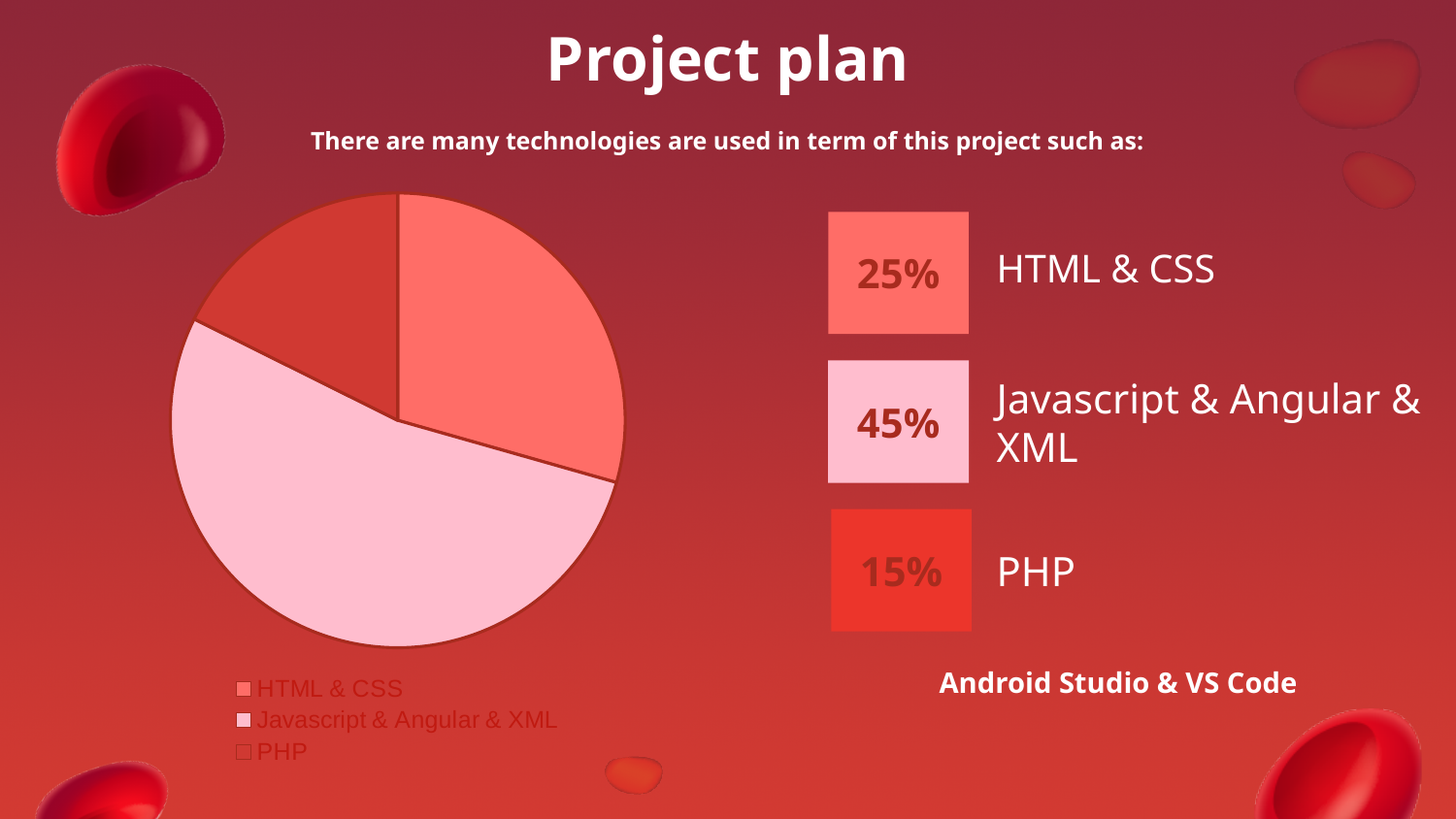
How many slices does the pie chart have? 3 What kind of chart is shown on the slide? pie chart Which technology has the largest slice of the pie chart? Javascript & Angular & XML What percentage is shown for PHP? 15% Which technology has the smallest slice of the pie chart? PHP Which legend entry is shown in light pink? Javascript & Angular & XML What percentage is shown for Javascript & Angular & XML? 45% Which is larger, the slice for HTML & CSS or the slice for PHP? HTML & CSS How many entries does the pie chart's legend list? 3 What percentage is shown for HTML & CSS? 25% What is the difference in percentage points between Javascript & Angular & XML and HTML & CSS? 20 What is the difference in percentage points between HTML & CSS and PHP? 10